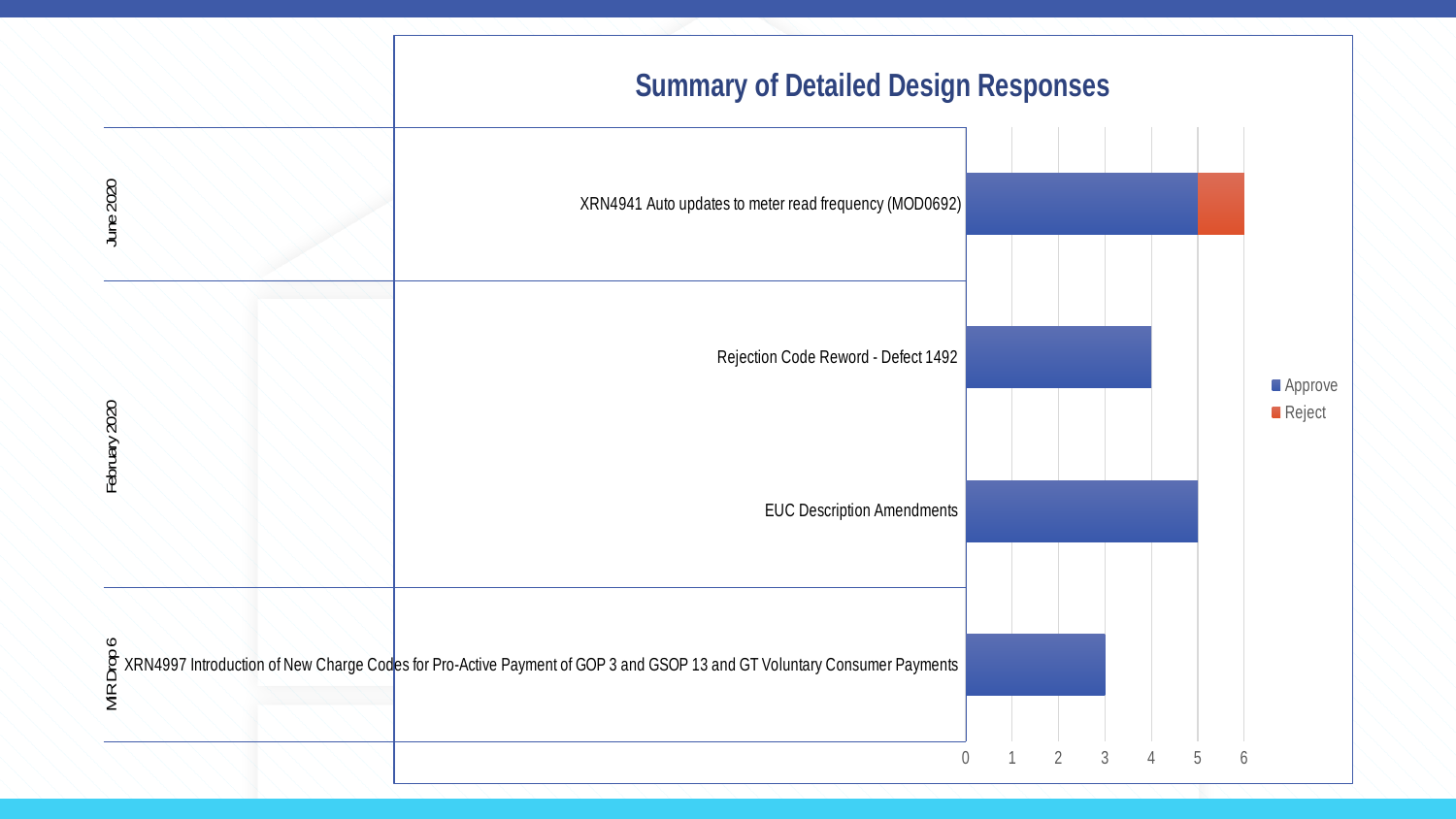
What is the total of the stacked bar for XRN4941 Auto updates to meter read frequency (MOD0692)? 6 What is the difference between the Approve values for EUC Description Amendments and XRN4997 Introduction of New Charge Codes for Pro-Active Payment of GOP 3 and GSOP 13 and GT Voluntary Consumer Payments? 2 Which is larger, the Approve value for EUC Description Amendments or for Rejection Code Reword - Defect 1492? EUC Description Amendments What is the Approve value for XRN4997 Introduction of New Charge Codes for Pro-Active Payment of GOP 3 and GSOP 13 and GT Voluntary Consumer Payments? 3 How many categories are plotted in the chart? 4 What kind of chart is shown on the slide? bar chart What is the Reject value for XRN4941 Auto updates to meter read frequency (MOD0692)? 1 Which category has the lowest Approve value? XRN4997 Introduction of New Charge Codes for Pro-Active Payment of GOP 3 and GSOP 13 and GT Voluntary Consumer Payments How many series does the legend list? 2 What is the Approve value for EUC Description Amendments? 5 What is the title of the chart? Summary of Detailed Design Responses What is the Approve value for Rejection Code Reword - Defect 1492? 4